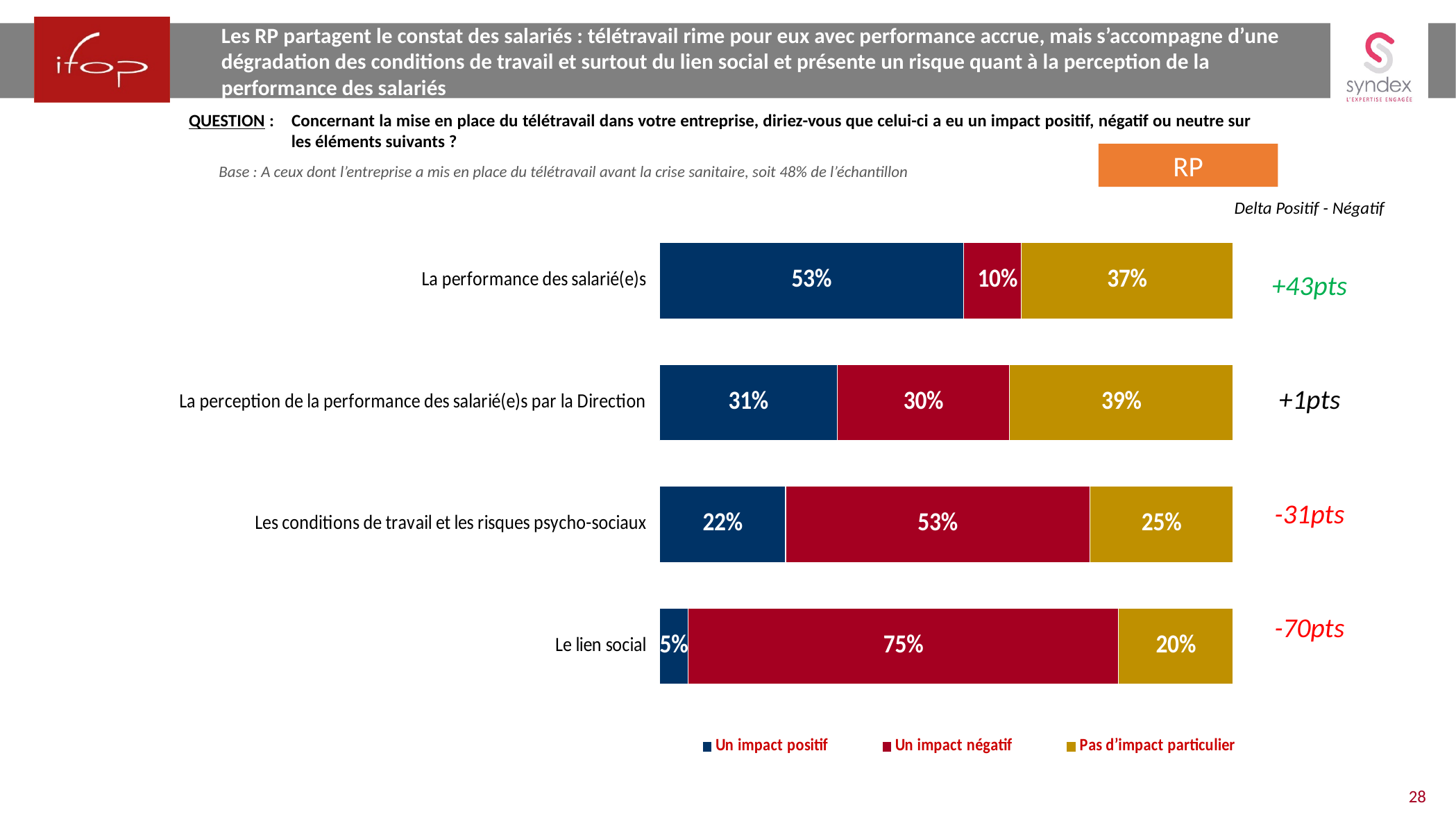
How many categories are shown in the chart? 4 What percentage of RP say telework had a positive impact on 'La performance des salarié(e)s'? 53% Which category has the highest 'Un impact négatif' value? Le lien social Which is larger for 'La perception de la performance des salarié(e)s par la Direction': the 'Un impact positif' value or the 'Pas d'impact particulier' value? Pas d'impact particulier What percentage of RP say telework had a negative impact on 'Le lien social'? 75% What is the difference between the 'Un impact négatif' and 'Un impact positif' values for 'Les conditions de travail et les risques psycho-sociaux'? 31% What is the 'Pas d'impact particulier' value for 'La perception de la performance des salarié(e)s par la Direction'? 39% How many series does the legend list? 3 Which colour represents 'Un impact négatif' in the chart? Red What kind of chart is shown on the slide? Stacked bar chart What is the 'Delta Positif - Négatif' shown for 'Le lien social'? -70pts Which category has the lowest 'Un impact positif' value? Le lien social